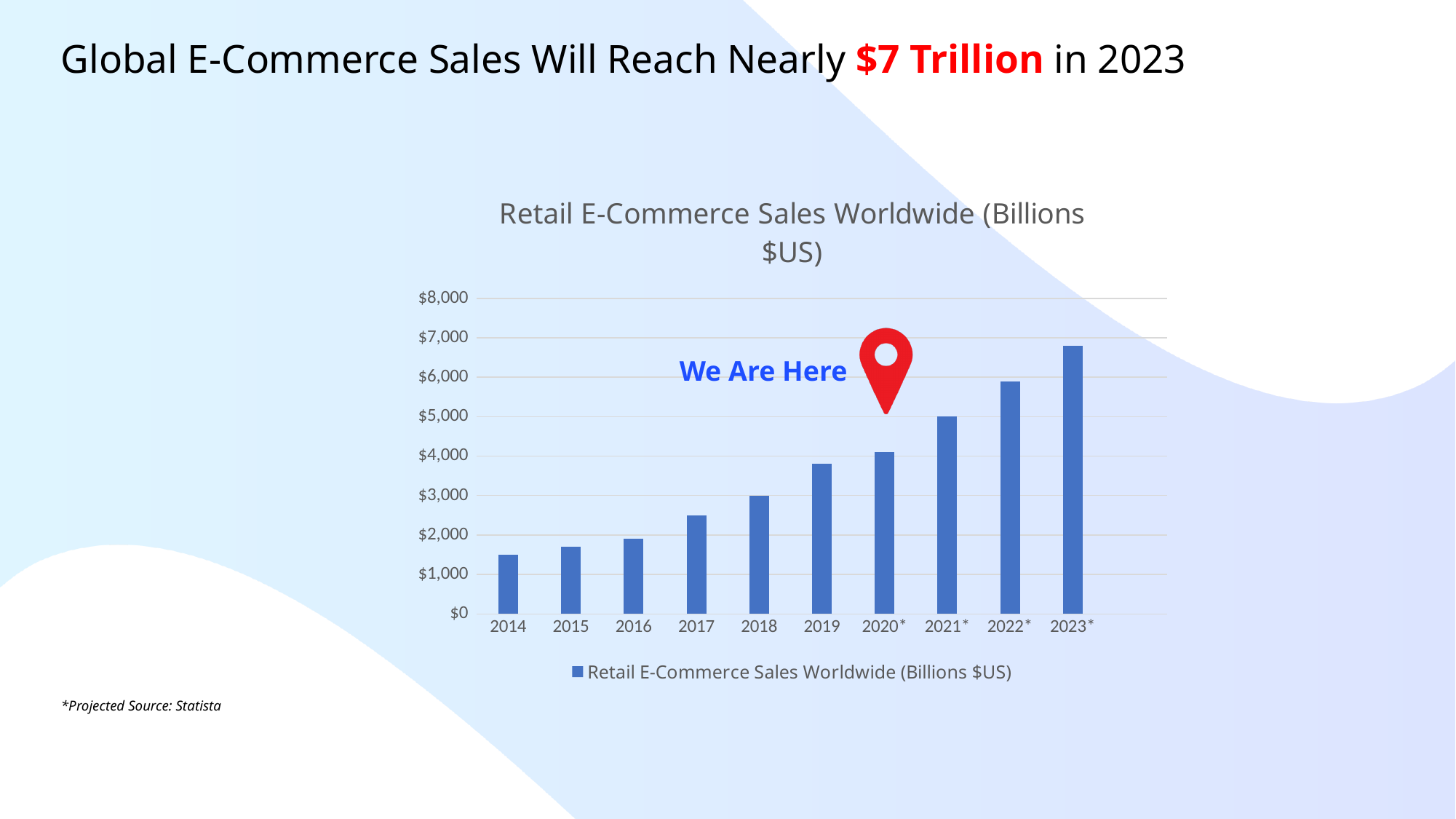
Is the value for 2022* greater or less than $5,000? greater How many years are shown on the x axis of the chart? 10 Which year has the highest retail e-commerce sales in the chart? 2023* Which year has the lowest retail e-commerce sales in the chart? 2014 Is the value for 2019 greater or less than $4,000? less How many series does the chart legend list? 1 Is the value for 2023* greater or less than $6,000? greater What is the title of the chart? Retail E-Commerce Sales Worldwide (Billions $US) What type of chart is shown on the slide? bar chart Do retail e-commerce sales rise or fall from 2014 to 2023 in the chart? rise Which year has larger retail e-commerce sales, 2017 or 2021*? 2021*